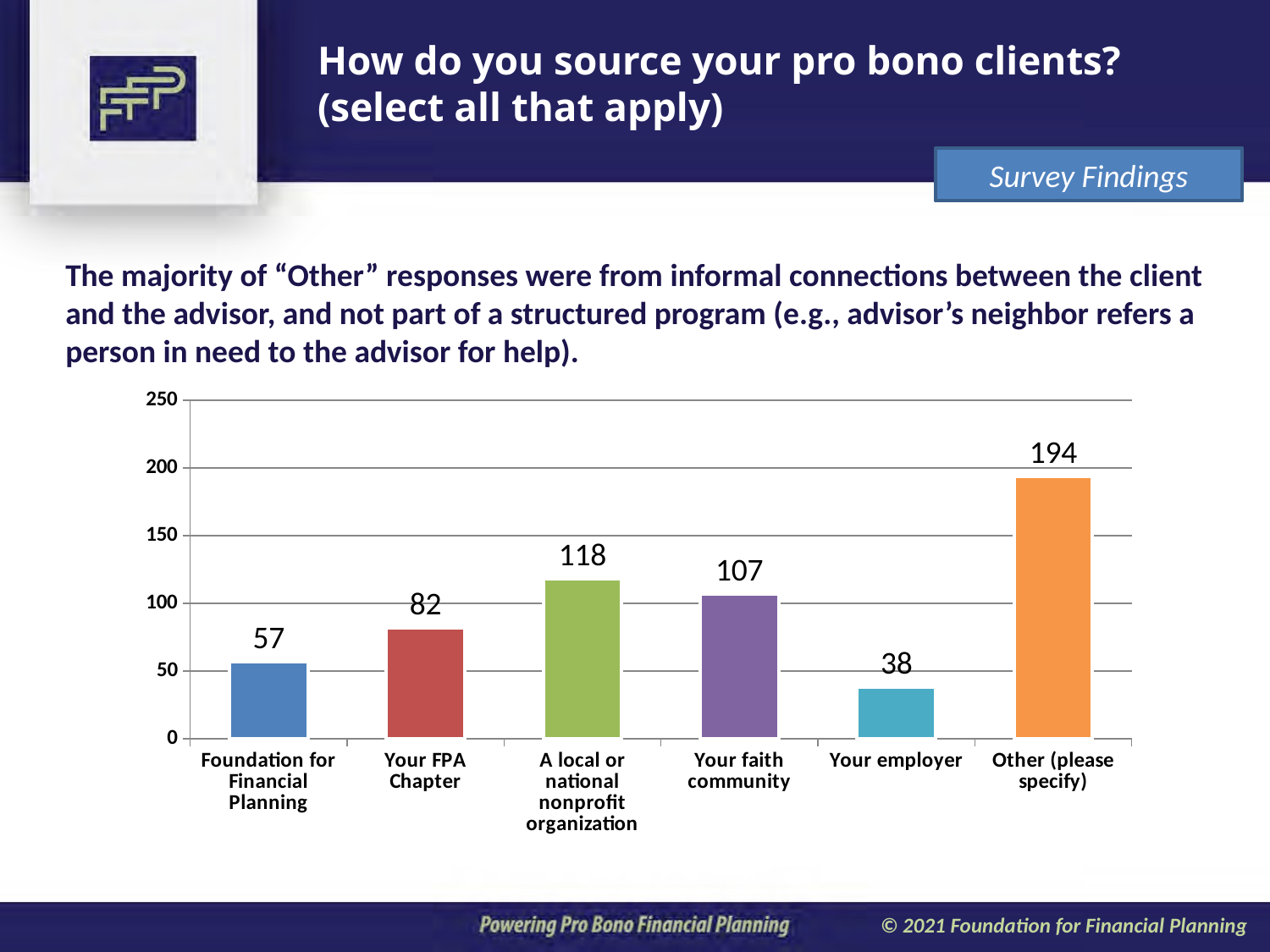
Which is larger, the value for "A local or national nonprofit organization" or the value for "Your faith community"? A local or national nonprofit organization What is the value for "Your faith community"? 107 What is the difference between the values for "Other (please specify)" and "A local or national nonprofit organization"? 76 Which category has the lowest value? Your employer What is the value for "Your FPA Chapter"? 82 What colour is the bar for "Other (please specify)"? orange What is the difference between the values for "Your FPA Chapter" and "Your employer"? 44 Which category has the highest value? Other (please specify) What is the value for "Foundation for Financial Planning"? 57 How many categories are shown on the x axis? 6 What kind of chart is shown on the slide? bar chart Is the value for "Your employer" greater or less than 50? less